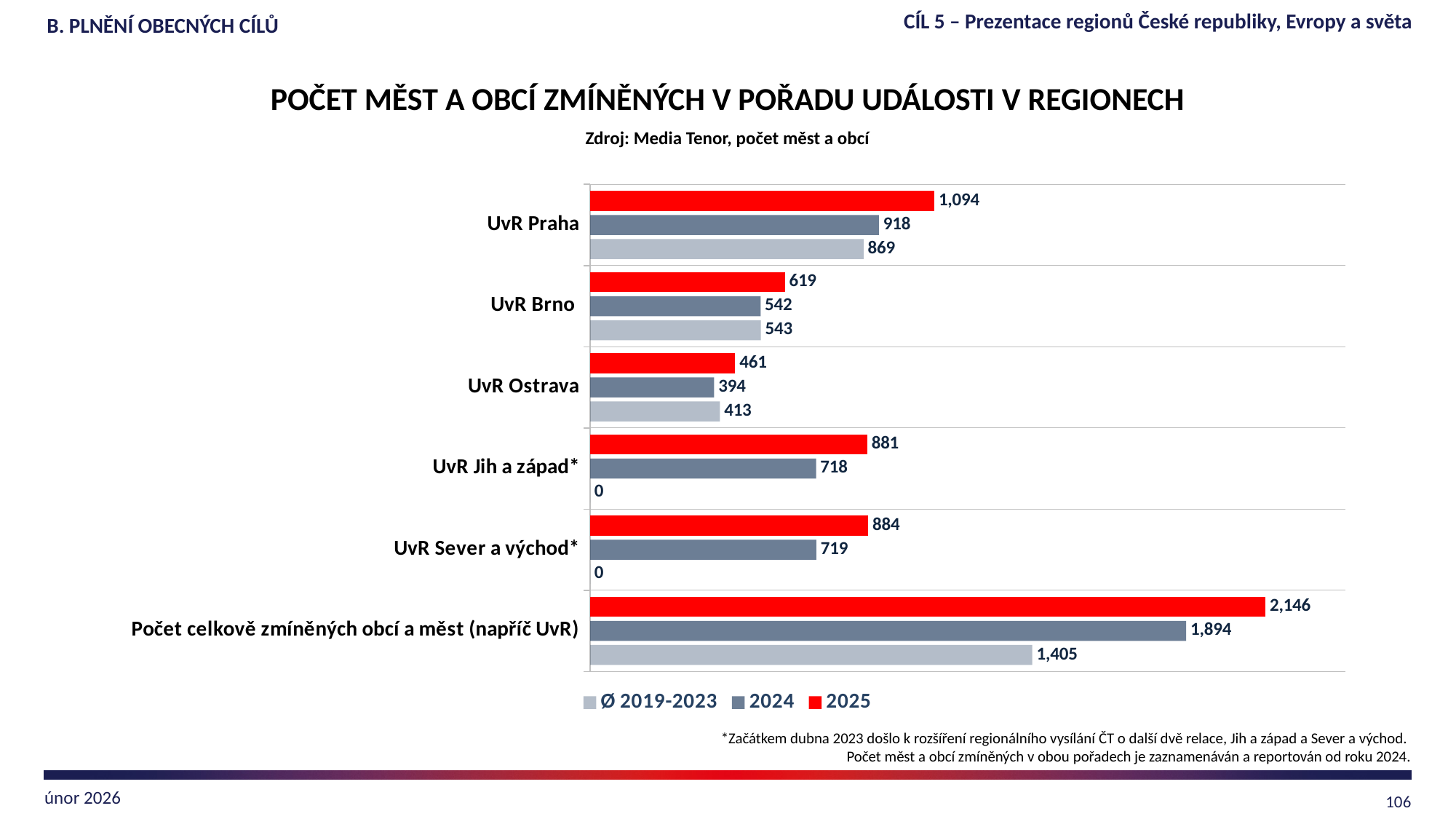
What is the 2025 value for UvR Praha? 1,094 What is the Ø 2019-2023 value for UvR Ostrava? 413 Which category has the highest 2025 value? Počet celkově zmíněných obcí a měst (napříč UvR) How many series does the legend list? 3 What kind of chart is shown on the slide? Bar chart Among the UvR regions, which has the lowest 2024 value? UvR Ostrava What is the 2025 value for Počet celkově zmíněných obcí a měst (napříč UvR)? 2,146 Which is larger for UvR Sever a východ*: the 2025 value or the 2024 value? 2025 What is the difference between the 2025 and 2024 values for UvR Praha? 176 Which colour represents the 2025 series in the chart? Red How many categories are shown on the chart? 6 What is the 2024 value for UvR Brno? 542